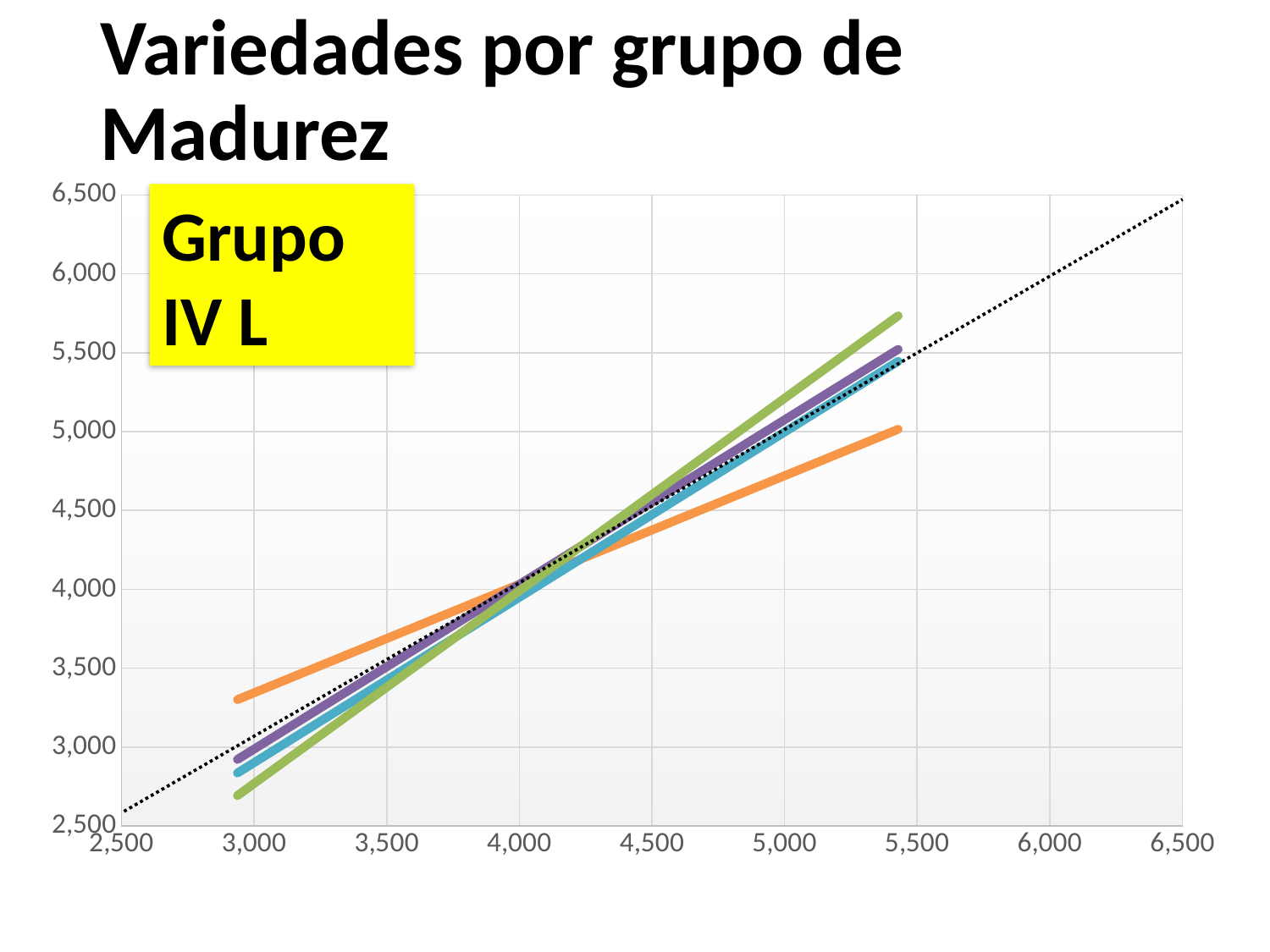
Which coloured line has the steepest slope? green Is the value of the green line at its left end greater or less than 3,000? less How many solid coloured lines are plotted on the chart (excluding the dotted line)? 4 What kind of chart is shown on the slide? line chart Which coloured line has the flattest slope? orange What text appears in the yellow box on the chart? Grupo IV L Do the coloured lines rise or fall as the x-axis value increases? rise At the left end of the lines (around x = 3,000), is the orange line or the green line higher? orange Is the value of the green line at its right end greater or less than 5,500? greater Is the value of the orange line at its left end greater or less than 3,000? greater At the right end of the lines (around x = 5,400), is the green line or the orange line higher? green What is the title of the slide chart? Variedades por grupo de Madurez